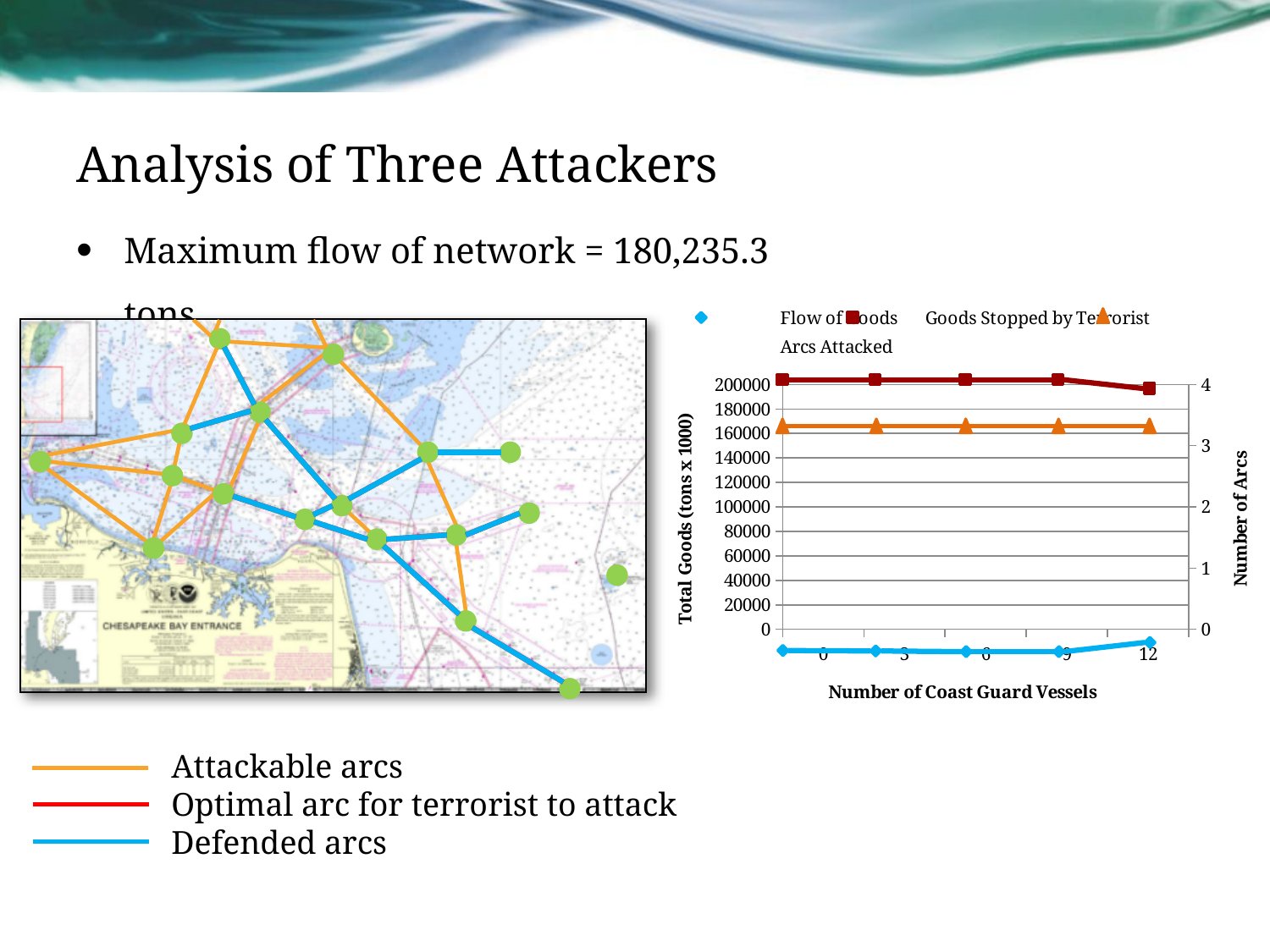
Is the value of Goods Stopped by Terrorist at 6 Coast Guard Vessels greater or less than 140000? greater Is the value of Flow of Goods at 12 Coast Guard Vessels greater or less than 160000? less What kind of chart is shown on the right side of the slide? line chart How many series does the legend of the chart list? 3 Does Flow of Goods rise or fall between 9 and 12 Coast Guard Vessels? rise Which series has the highest values on the chart? Goods Stopped by Terrorist How many values of Number of Coast Guard Vessels are labelled on the x axis of the chart? 5 Is the value of Flow of Goods at 0 Coast Guard Vessels greater or less than 180000? less At 3 Coast Guard Vessels, which is larger: Flow of Goods or Goods Stopped by Terrorist? Goods Stopped by Terrorist What is the title of the left y axis of the chart? Total Goods (tons x 1000) What is the title of the x axis of the chart? Number of Coast Guard Vessels